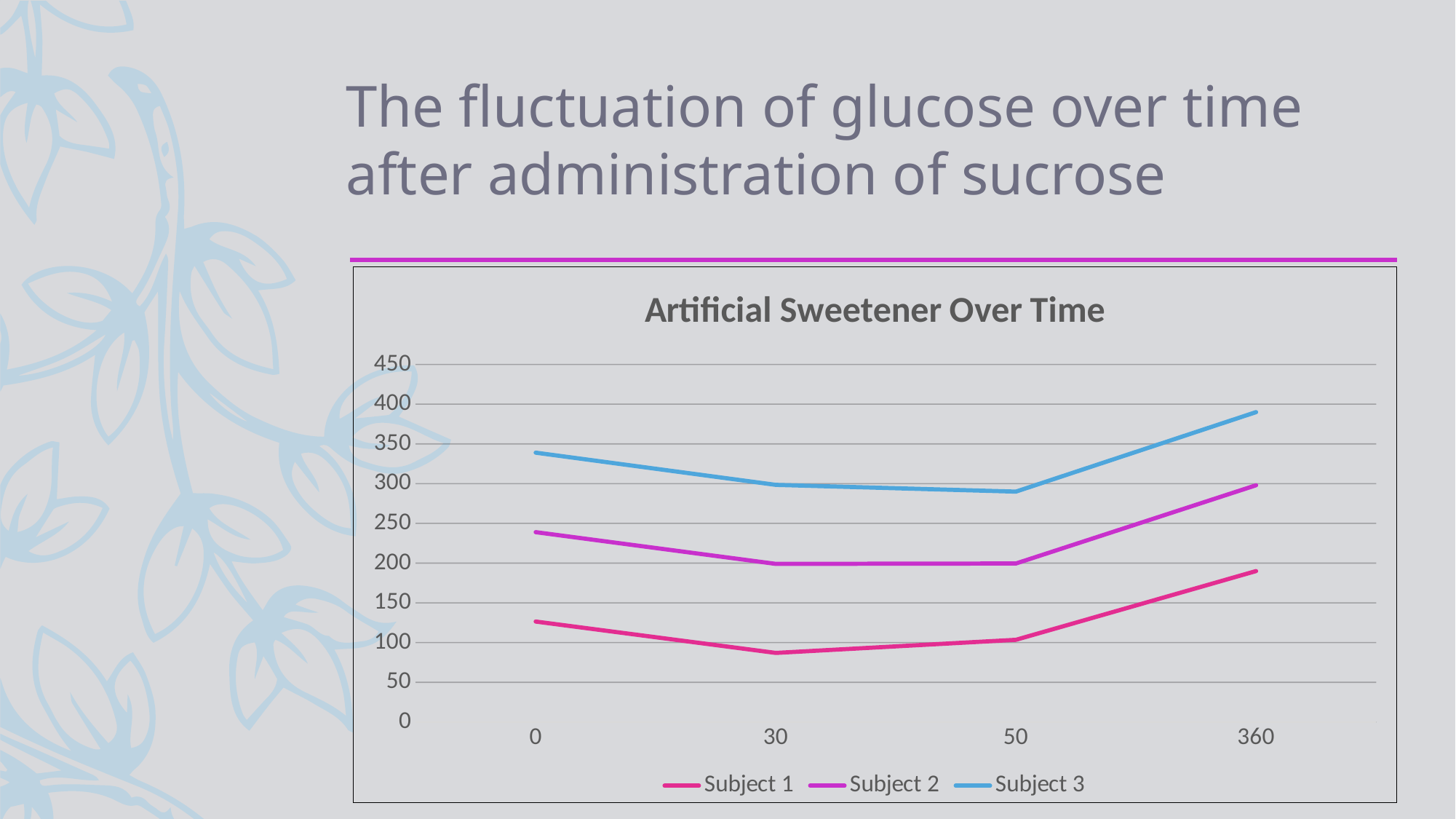
Which is larger: Subject 2's value at time 0 or Subject 1's value at time 360? Subject 2's value at time 0 Is the value for Subject 3 at time 360 greater or less than 350? greater Which subject has the highest value at time 360? Subject 3 What colour is the line for Subject 3 in the legend? Blue What is the title of the chart? Artificial Sweetener Over Time What kind of chart is shown on the slide? Line chart Does the line for Subject 1 rise or fall between time 50 and time 360? Rise Does the line for Subject 3 rise or fall between time 0 and time 30? Fall Is the value for Subject 1 at time 30 greater or less than 100? less How many series does the legend list? 3 How many time points are plotted along the x axis? 4 Which subject has the lowest value at time 0? Subject 1